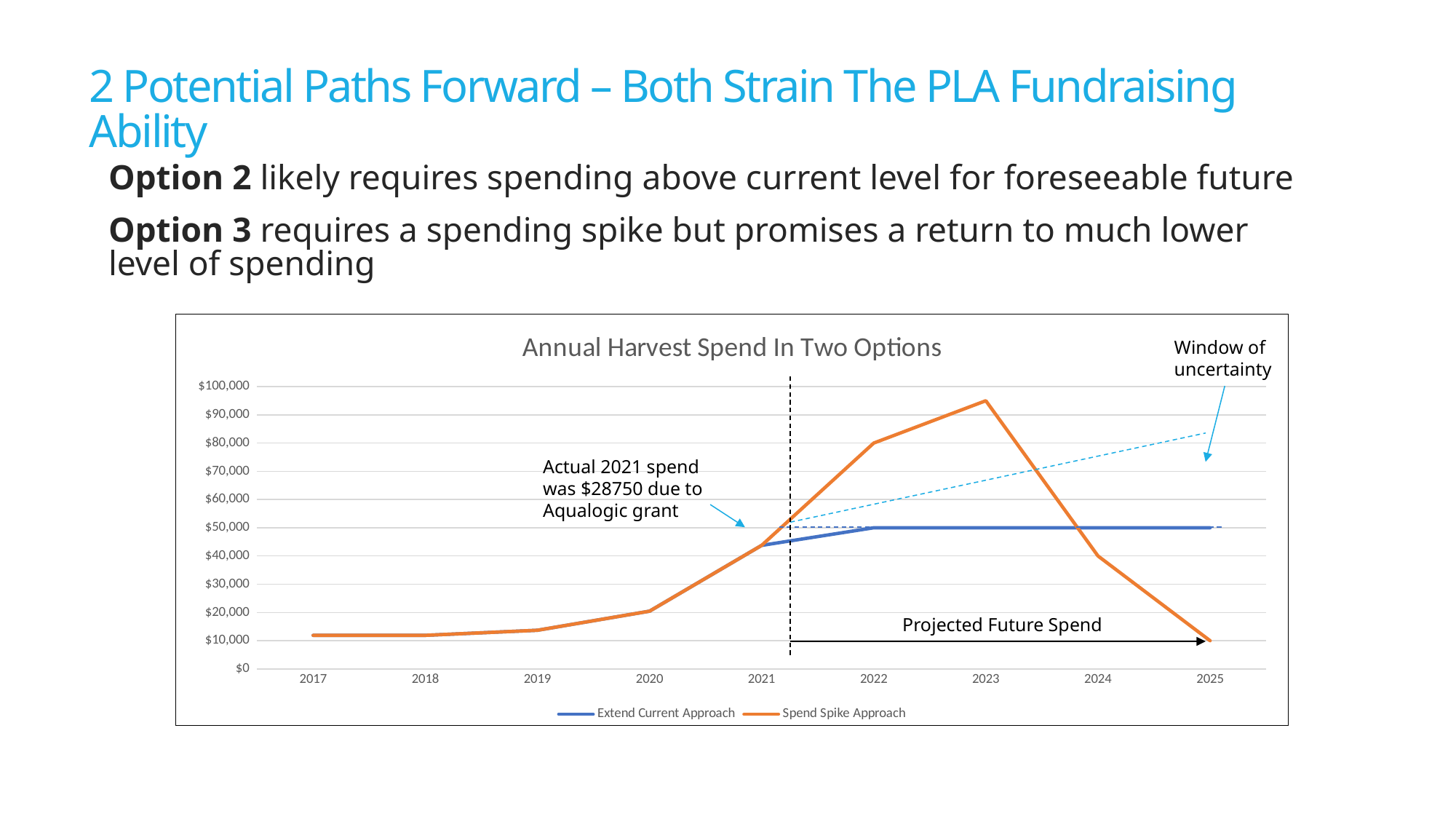
Is the value for the Spend Spike Approach in 2023 greater or less than $90,000? greater How many years are shown on the x axis of the chart? 9 Does the Spend Spike Approach rise or fall from 2023 to 2025? fall In which year does the Spend Spike Approach reach its highest value? 2023 Which series has the higher value in 2024, Extend Current Approach or Spend Spike Approach? Extend Current Approach Which series has the higher value in 2023, Extend Current Approach or Spend Spike Approach? Spend Spike Approach How many series does the chart legend list? 2 Is the value for the Spend Spike Approach in 2022 greater or less than $70,000? greater What kind of chart is shown on the slide? line chart Which series is drawn in orange in the chart? Spend Spike Approach Is the value for the Spend Spike Approach in 2020 greater or less than $30,000? less What is the title of the chart? Annual Harvest Spend In Two Options